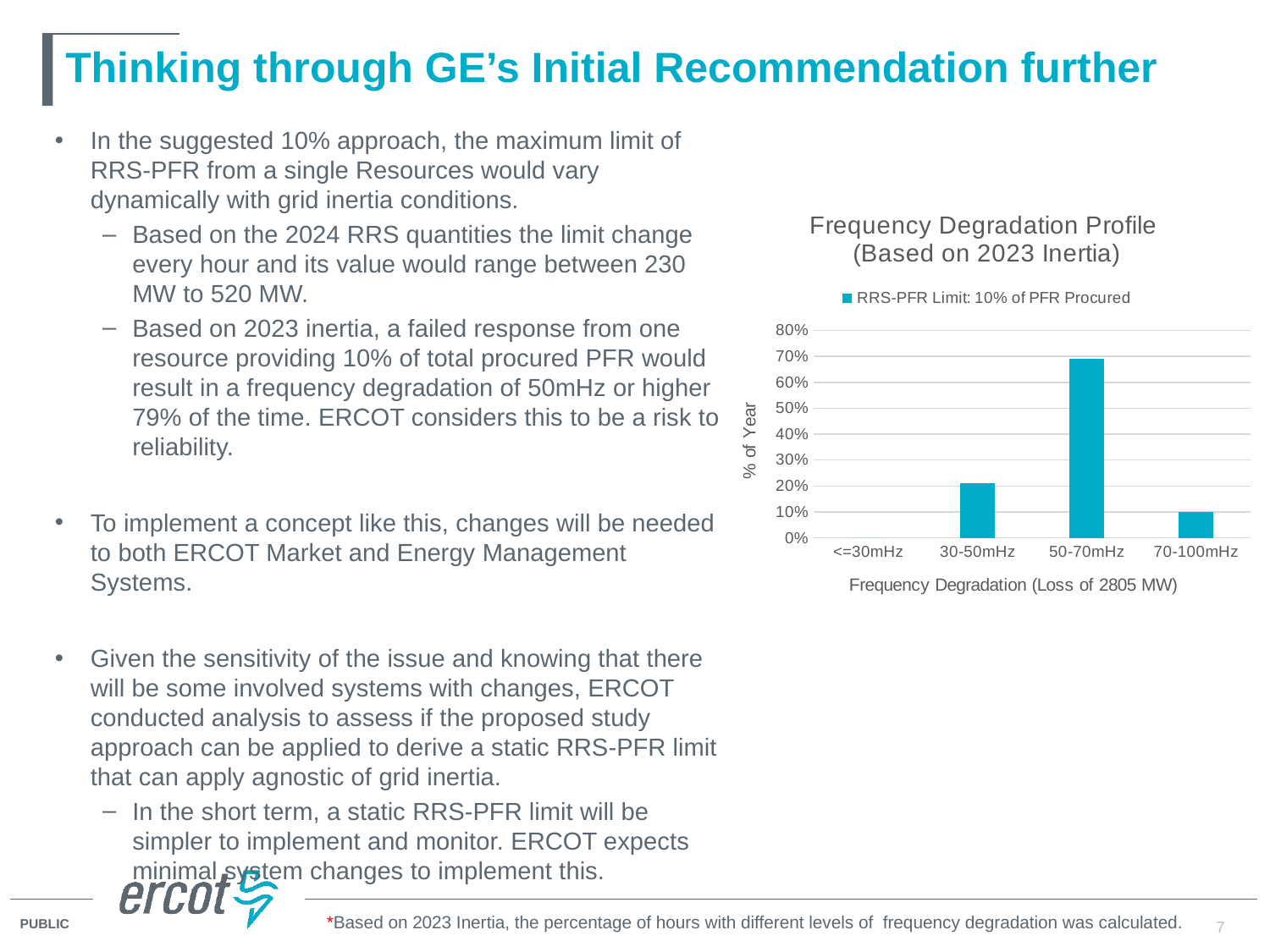
What is the title of the chart? Frequency Degradation Profile (Based on 2023 Inertia) Is the value for 50-70mHz greater or less than 60%? greater Which frequency degradation category has the highest % of Year? 50-70mHz How many categories are shown on the x axis of the chart? 4 Which frequency degradation category has the lowest % of Year? <=30mHz What kind of chart is shown on the slide? bar chart Which has a larger % of Year, 30-50mHz or 70-100mHz? 30-50mHz Is the value for 30-50mHz greater or less than 30%? less How many series does the chart's legend list? 1 What is the label of the x axis of the chart? Frequency Degradation (Loss of 2805 MW) Is the value for 70-100mHz greater or less than 20%? less